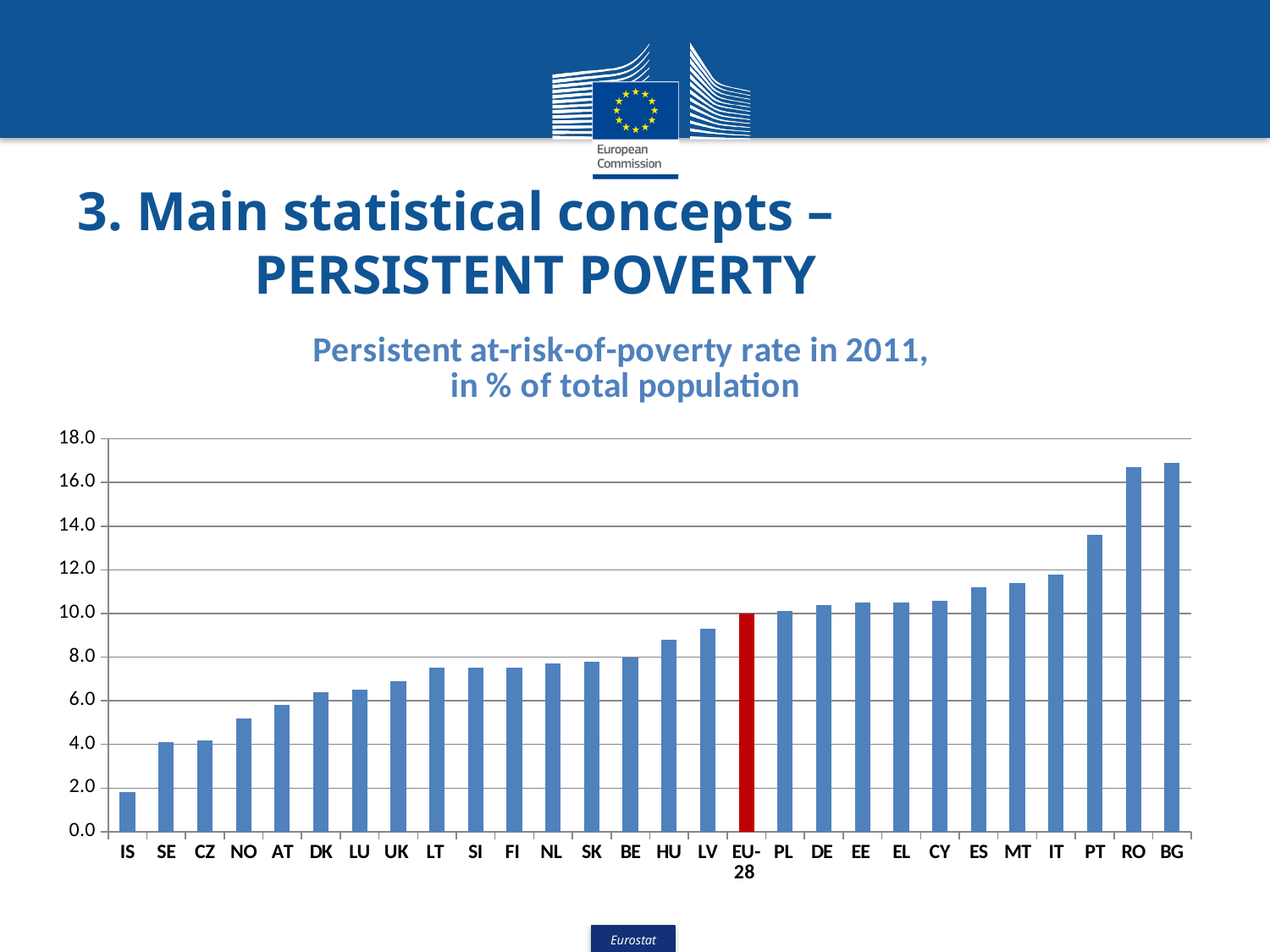
Which has the higher persistent at-risk-of-poverty rate, SE or NO? NO Is the value for DK greater or less than 8.0? less Which has the higher persistent at-risk-of-poverty rate, PT or IT? PT Is the value for PT greater or less than 12.0? greater Which bar in the chart is coloured red instead of blue? EU-28 What kind of chart is shown on the slide? bar chart Is the value for RO greater or less than 16.0? greater Do the values generally rise or fall moving from left to right along the x axis? rise Which category has the lowest persistent at-risk-of-poverty rate in the chart? IS How many countries/categories are plotted on the x axis of the chart? 28